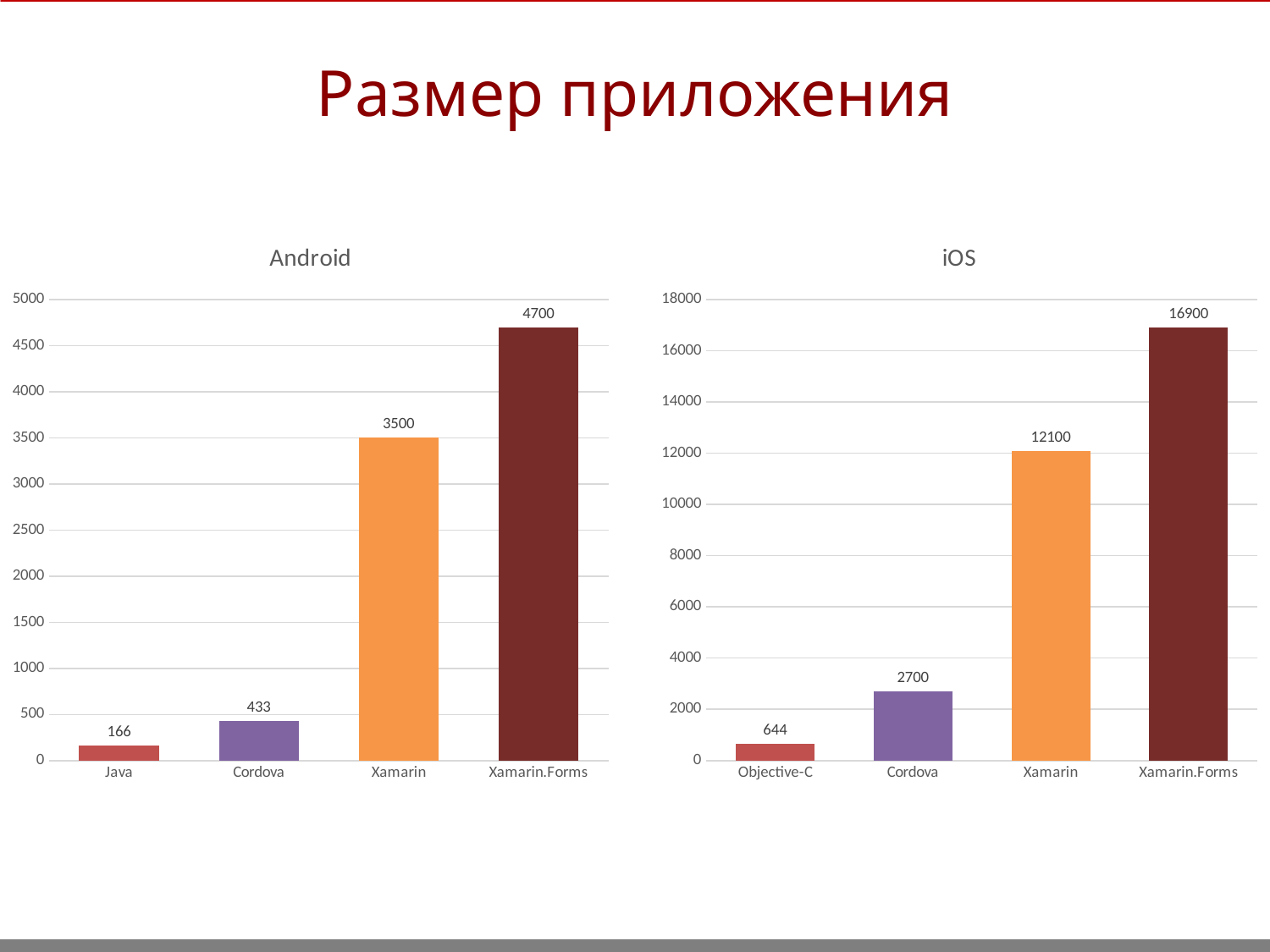
In the Android chart, which category has the highest value? Xamarin.Forms In the Android chart, is the value for Cordova greater or less than 500? less What is the title of the chart on the right side of the slide? iOS How many categories are shown in the iOS chart? 4 What kind of chart is the Android chart? bar chart In the iOS chart, what is the difference between the values for Xamarin.Forms and Xamarin? 4800 In the iOS chart, what is the value for Cordova? 2700 In the iOS chart, do the values rise or fall from left to right along the x axis? rise In the Android chart, what is the difference between the values for Xamarin.Forms and Xamarin? 1200 In the Android chart, what is the value for Xamarin? 3500 In the iOS chart, which category has the lowest value? Objective-C In the iOS chart, which is larger, the value for Cordova or the value for Objective-C? Cordova